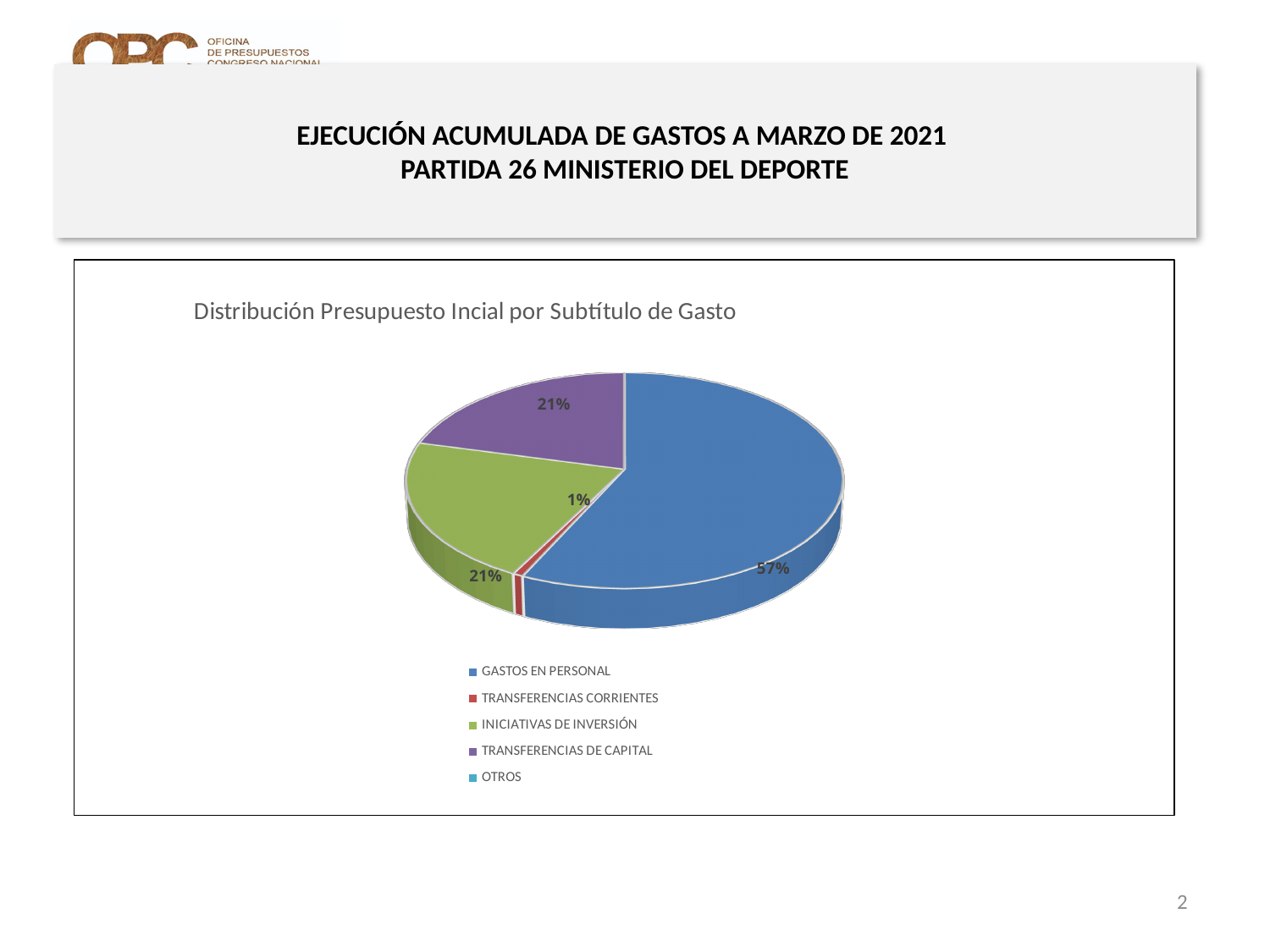
What share of the pie does TRANSFERENCIAS CORRIENTES represent? 1% What is the difference in percentage points between GASTOS EN PERSONAL and INICIATIVAS DE INVERSIÓN? 36 percentage points What type of chart is shown on the slide? Pie chart What share of the pie does TRANSFERENCIAS DE CAPITAL represent? 21% Which is larger, the share for GASTOS EN PERSONAL or the share for TRANSFERENCIAS DE CAPITAL? GASTOS EN PERSONAL What share of the pie does GASTOS EN PERSONAL represent? 57% What is the title of the chart? Distribución Presupuesto Incial por Subtítulo de Gasto What colour is the GASTOS EN PERSONAL slice? Blue Which category has the smallest printed percentage on the pie? TRANSFERENCIAS CORRIENTES Which category has the largest slice of the pie? GASTOS EN PERSONAL How many entries does the legend list? 5